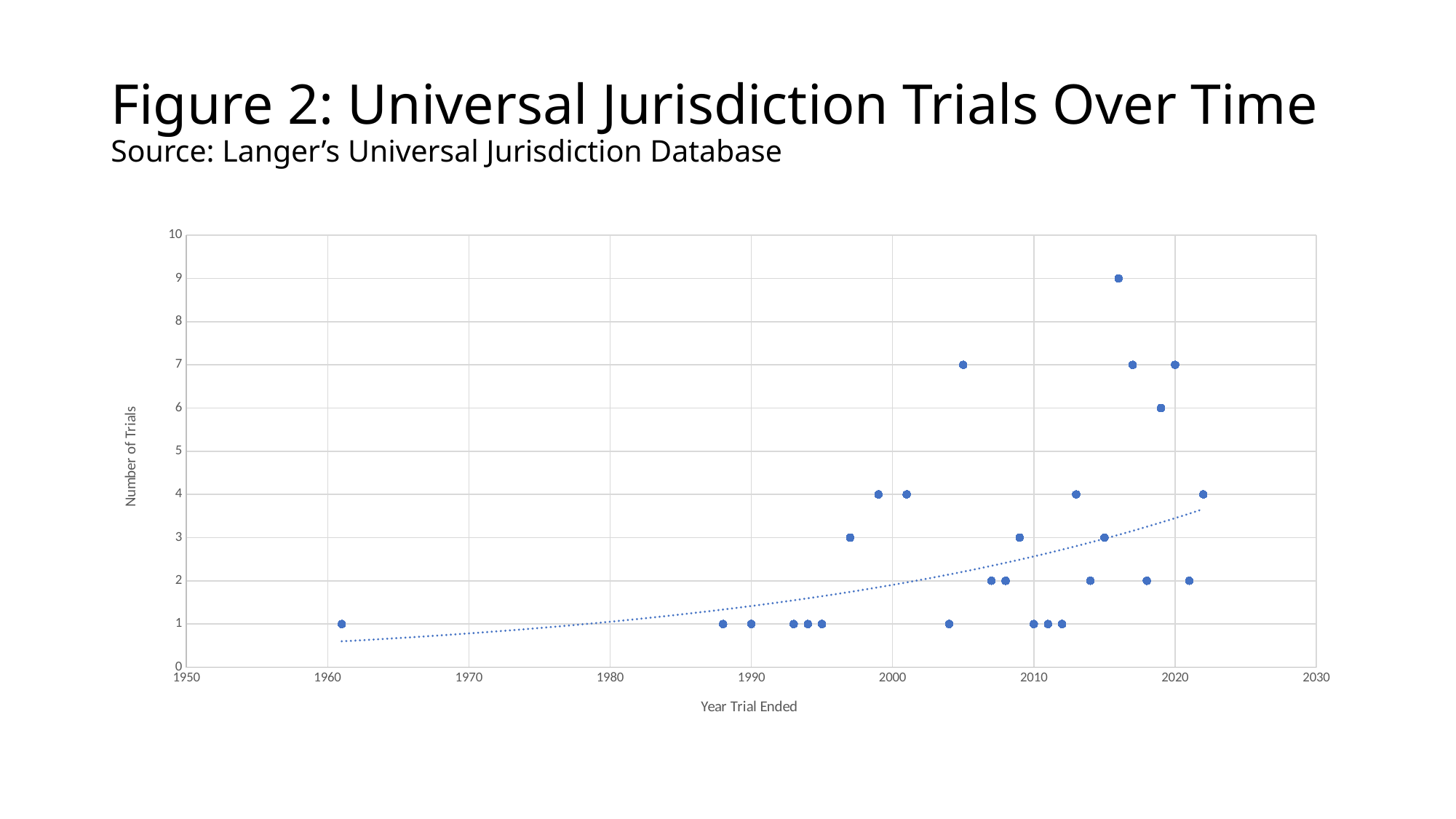
Which year has more trials, 2020 or 2010? 2020 What is the lowest number of trials plotted for any year? 1 What is the label of the x axis? Year Trial Ended What is the label of the y axis? Number of Trials How many trials are plotted for the year 2020? 7 Does the dotted trendline rise or fall as the year increases? rises How many trials are plotted for the year 2010? 1 What is the difference between the number of trials in 2020 and in 2010? 6 Is the highest plotted value greater or less than 8? greater What kind of chart is shown on the slide? scatter chart How many trials are plotted for the year 1990? 1 What is the highest number of trials plotted for any year? 9